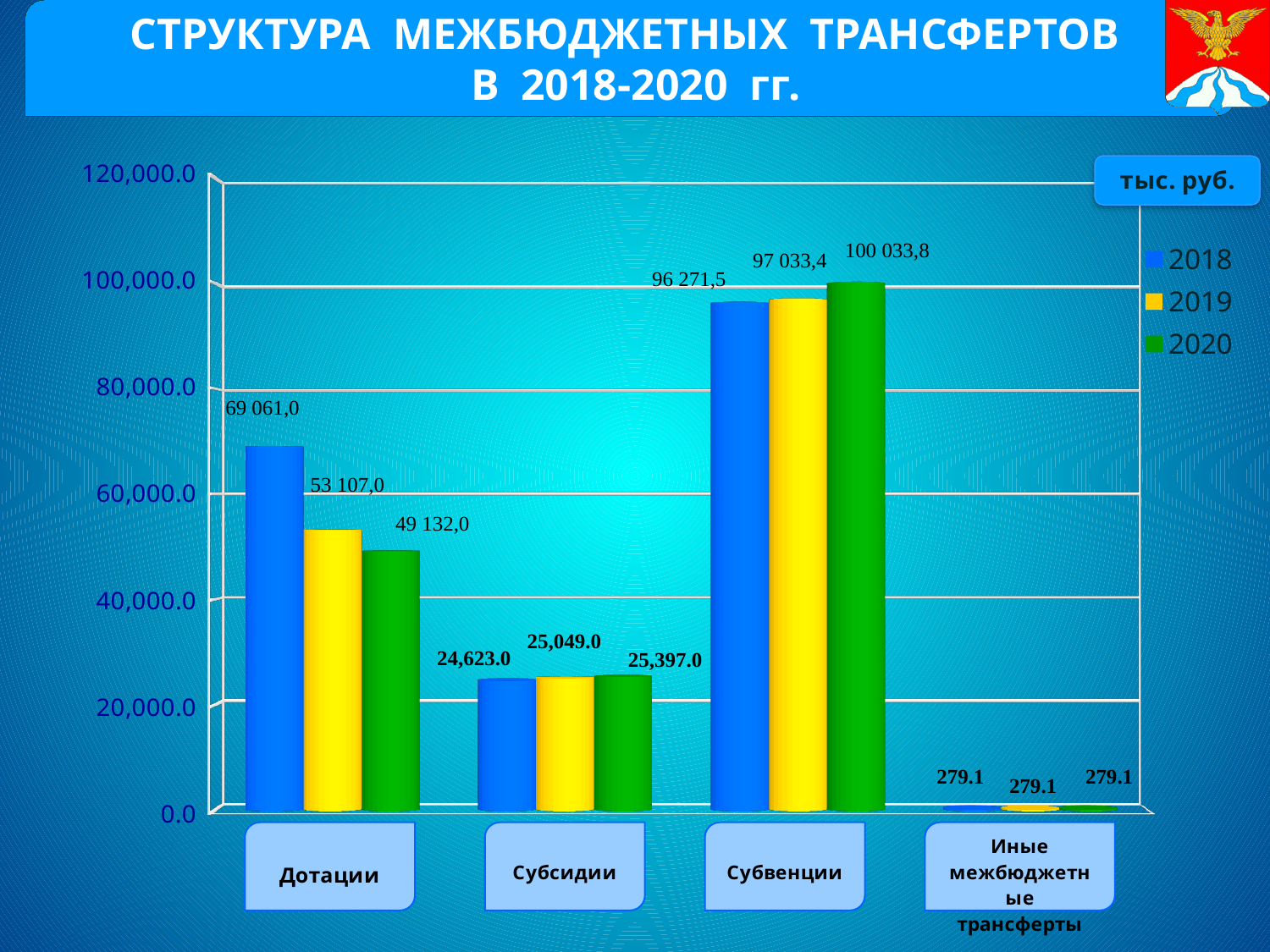
What is the value for Субвенции in 2020? 100 033,8 Which category has the highest value in 2020? Субвенции Is the 2019 value for Дотации greater or less than 60,000.0? less What is the value for Дотации in 2018? 69 061,0 What is the value for Субсидии in 2019? 25,049.0 What is the difference between the 2018 and 2020 values for Дотации? 19 929,0 Which category has the lowest value in 2019? Иные межбюджетные трансферты How many series does the legend list? 3 Which is larger for Субвенции: the 2018 value or the 2019 value? 2019 Do the values for Дотации rise or fall from 2018 to 2020? fall What is the value for Иные межбюджетные трансферты in 2018? 279.1 How many categories are shown on the x axis? 4